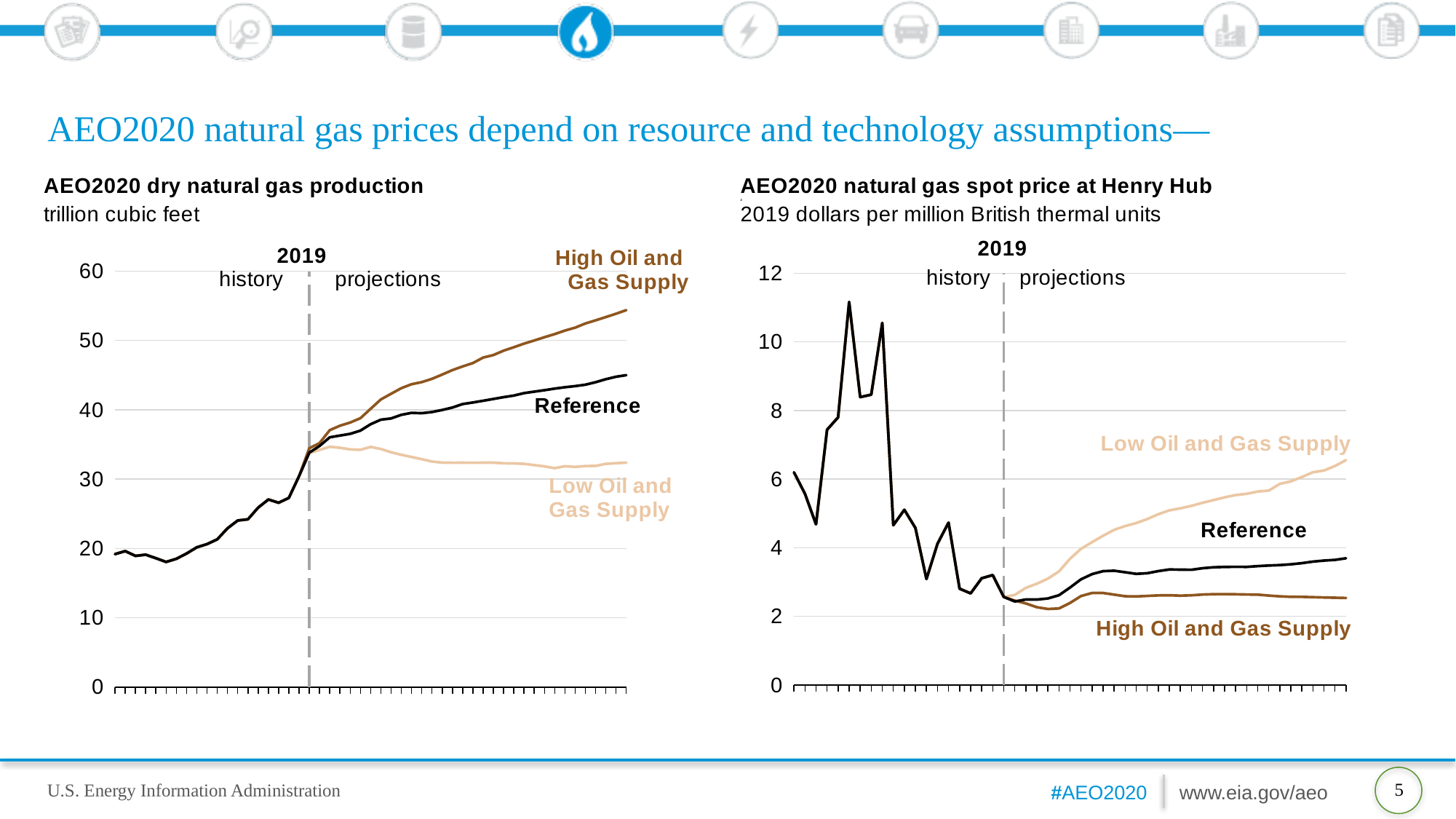
How many series are shown on the AEO2020 natural gas spot price at Henry Hub chart? 3 On the AEO2020 dry natural gas production chart, is the High Oil and Gas Supply value at the end of the projections greater or less than 50? greater On the AEO2020 natural gas spot price at Henry Hub chart, is the Low Oil and Gas Supply value at the end of the projections greater or less than 6? greater How many series are shown on the AEO2020 dry natural gas production chart? 3 On the AEO2020 natural gas spot price at Henry Hub chart, which series is highest at the end of the projection period? Low Oil and Gas Supply What type of chart is the AEO2020 dry natural gas production chart? line chart On the AEO2020 dry natural gas production chart, is the Low Oil and Gas Supply value at the end of the projections greater or less than 40? less On the AEO2020 dry natural gas production chart, which series is lowest at the end of the projection period? Low Oil and Gas Supply On the AEO2020 dry natural gas production chart, which series is highest at the end of the projection period? High Oil and Gas Supply On the AEO2020 dry natural gas production chart, does the High Oil and Gas Supply series rise or fall over the projection period? rise What unit is used on the AEO2020 dry natural gas production chart? trillion cubic feet